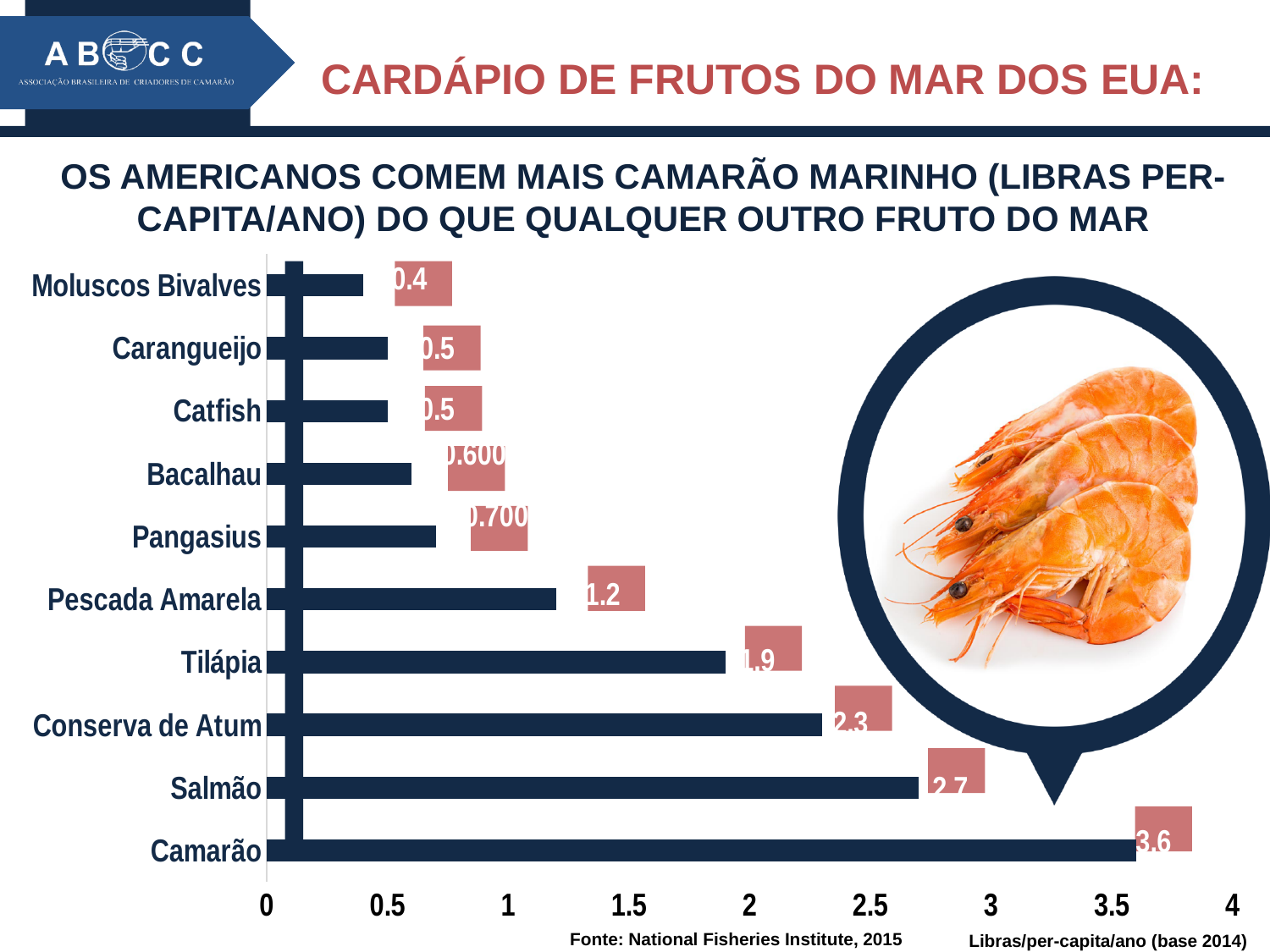
What is the difference between the values for Camarão and Conserva de Atum? 1.3 What unit label is shown under the x axis of the chart? Libras/per-capita/ano (base 2014) Which category has the lowest value in the chart? Moluscos Bivalves Which category has the highest value in the chart? Camarão What is the value for Camarão? 3.6 What is the value for Pescada Amarela? 1.2 Which is larger, the value for Tilápia or the value for Pescada Amarela? Tilápia Is the value for Salmão greater or less than 2.5? greater What is the value for Conserva de Atum? 2.3 What kind of chart is shown on the slide? bar chart How many seafood categories are plotted in the chart? 10 What is the value for Tilápia? 1.9